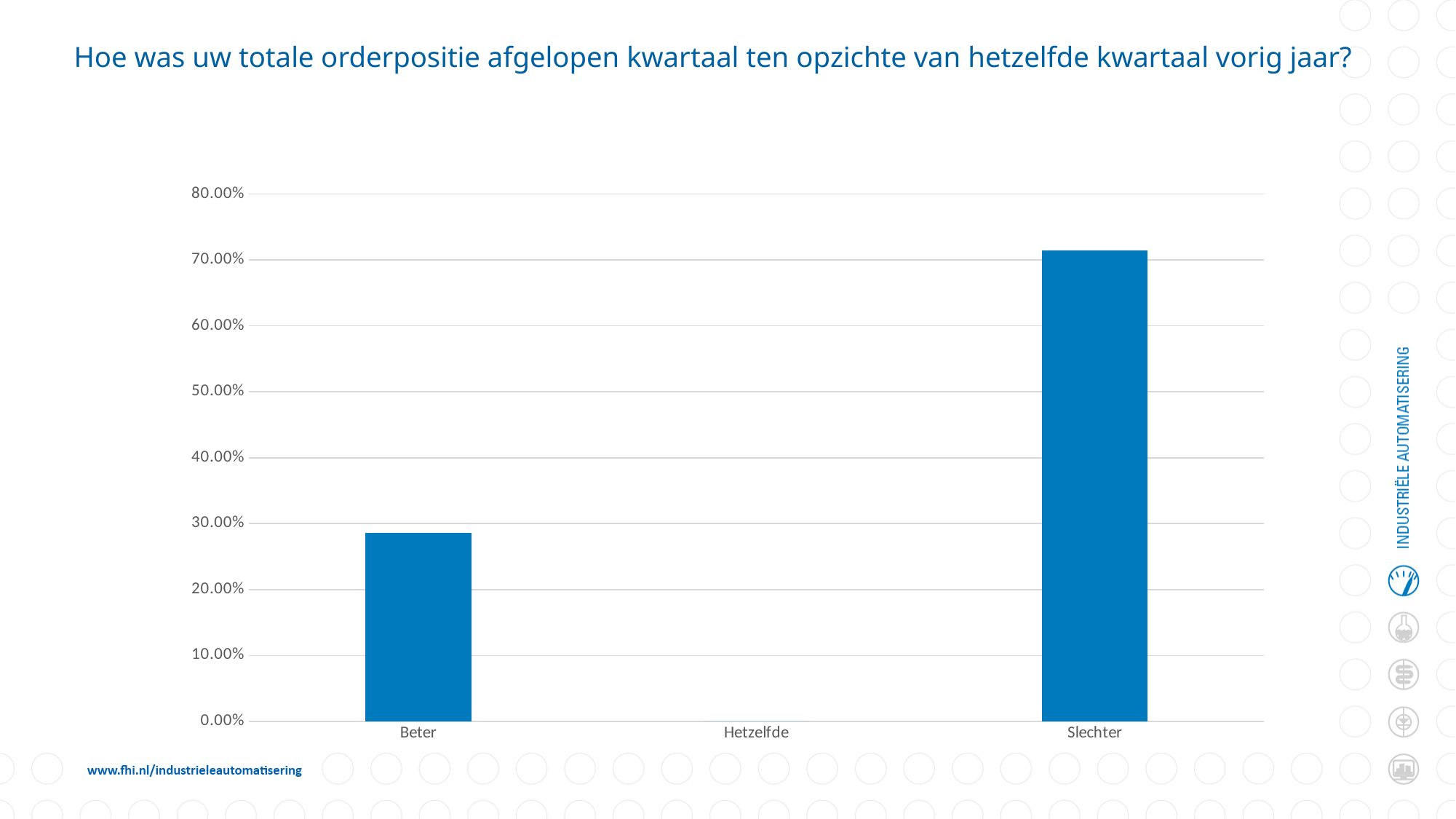
What is the title of the chart on the slide? Hoe was uw totale orderpositie afgelopen kwartaal ten opzichte van hetzelfde kwartaal vorig jaar? What kind of chart is shown on the slide? bar chart Which category has the lowest value in the chart? Hetzelfde Is the value for Slechter greater or less than 80.00%? less Is the value for Beter greater or less than 20.00%? greater Which is larger, the value for Beter or the value for Hetzelfde? Beter Is the value for Hetzelfde greater or less than 10.00%? less Which is larger, the value for Beter or the value for Slechter? Slechter Which category has the highest value in the chart? Slechter How many categories are shown on the x axis of the chart? 3